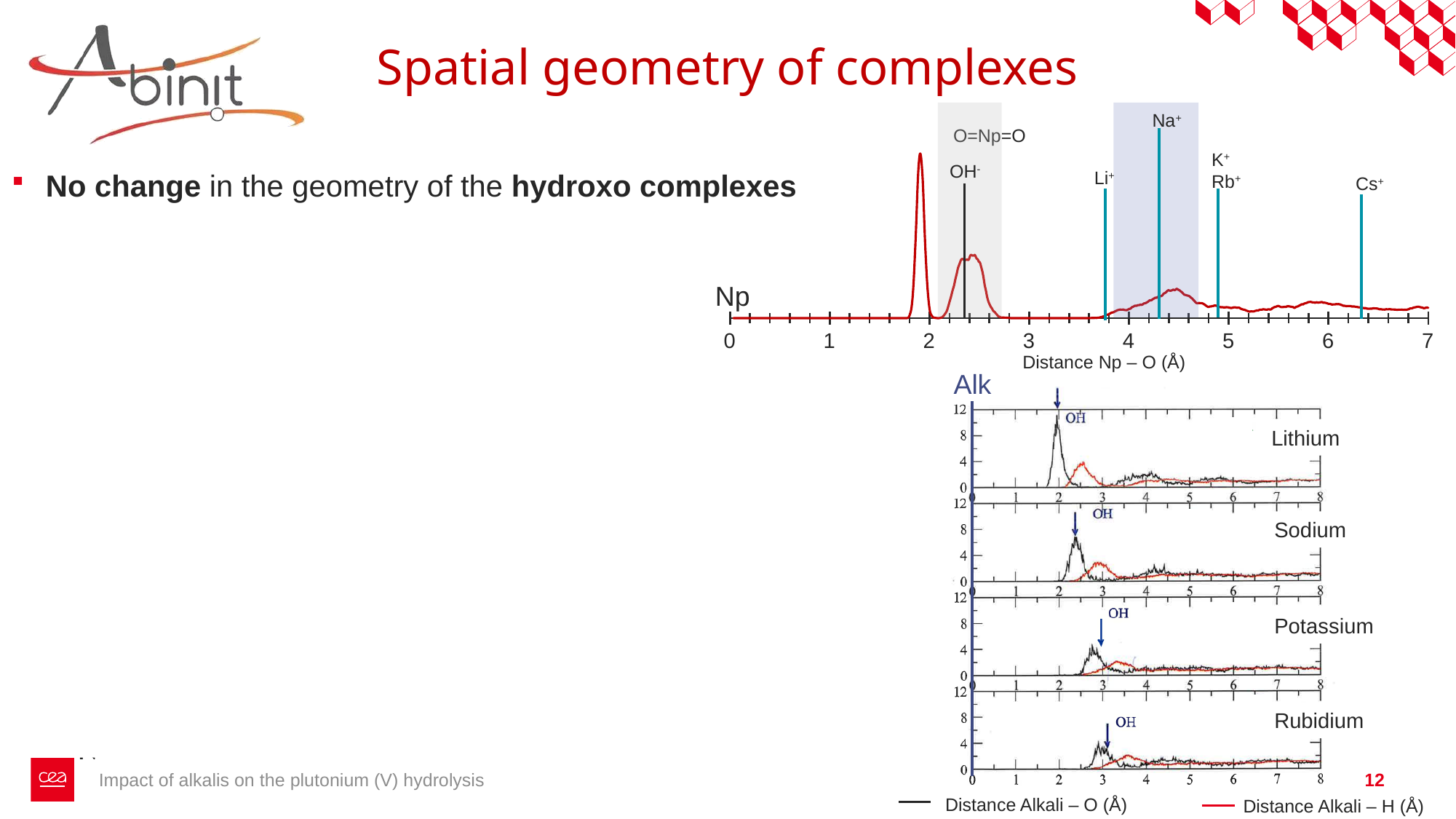
In the top chart (Distance Np – O), what is the label of the x axis? Distance Np – O (Å) In the top chart (Distance Np – O), is the Na+ vertical line at a distance greater or less than 4 Å? greater In the top chart (Distance Np – O), which alkali ion marker is at the smallest Np – O distance? Li+ In the bottom chart (Alk), how many series does the legend list? 2 In the top chart (Distance Np – O), is the Li+ vertical line at a distance greater or less than 4 Å? less In the bottom chart (Alk), which series is drawn in red according to the legend? Distance Alkali – H (Å) In the top chart (Distance Np – O), is the tallest red peak located at a distance greater or less than 2 Å? less In the top chart (Distance Np – O), which alkali ion marker is at the largest Np – O distance? Cs+ In the bottom chart (Alk), how many alkali panels are shown? 4 In the bottom chart (Alk), does the position of the OH arrow move to larger or smaller distances going from Lithium down to Rubidium? larger In the top chart (Distance Np – O), what is the highest value shown on the x axis? 7